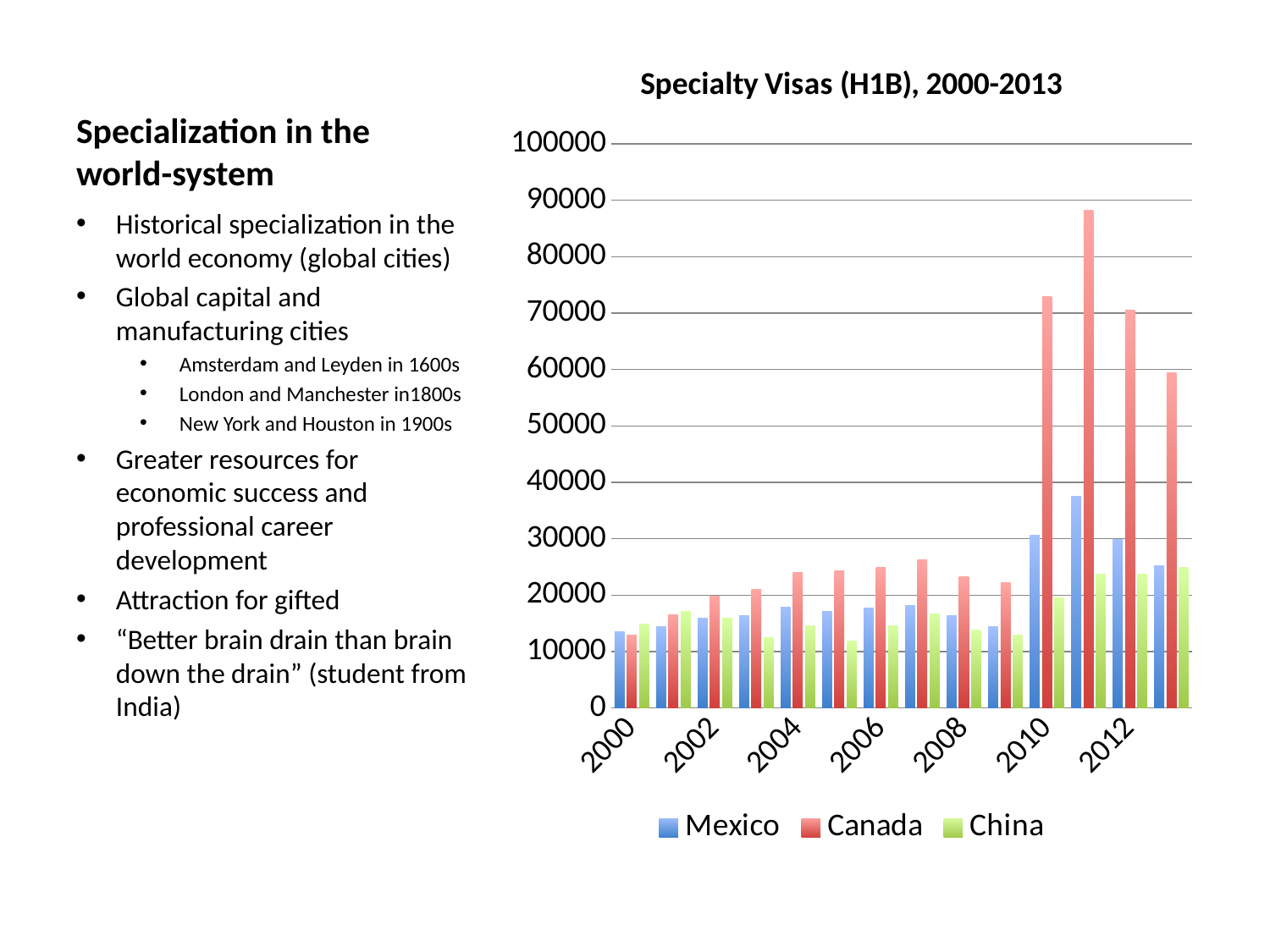
How many series does the chart's legend list? 3 In 2011, which is larger: the value for Mexico or the value for China? Mexico In which year does Canada reach its highest value? 2011 Which series are listed in the chart's legend? Mexico, Canada, China Is the value for Mexico in 2011 greater or less than 30000? greater Which series has the tallest bar in the chart? Canada Is the value for Canada in 2010 greater or less than 70000? greater What is the title of the chart? Specialty Visas (H1B), 2000-2013 Is the value for Canada in 2011 greater or less than 80000? greater What kind of chart is shown on the slide? bar chart In 2010, which is larger: the value for Canada or the value for Mexico? Canada